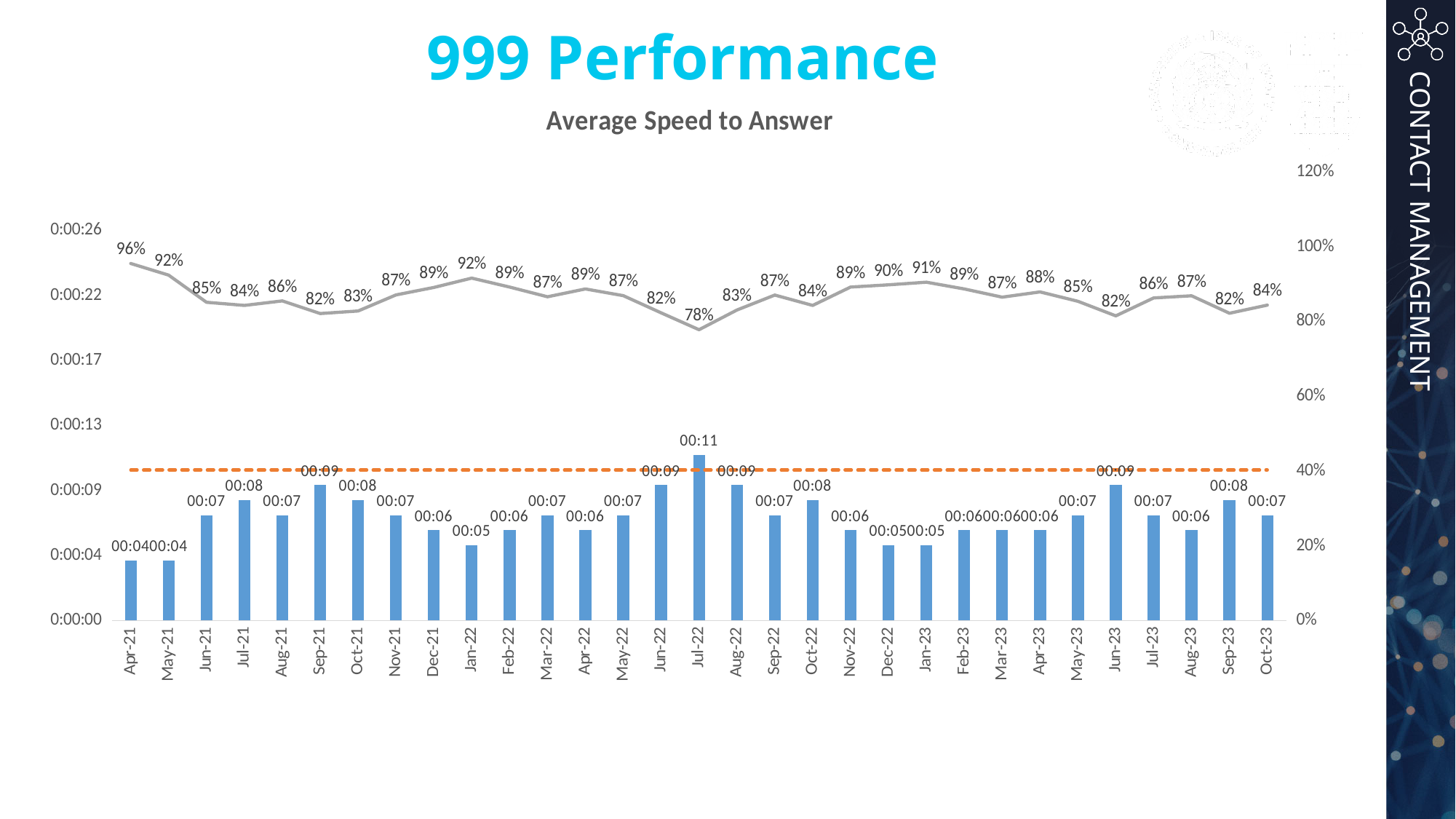
Which month has the highest percentage value on the line? Apr-21 Which month has the highest average speed to answer bar? Jul-22 How many months are plotted along the x axis? 31 What percentage value is shown on the line for Apr-21? 96% Which month has the lowest percentage value on the line? Jul-22 What is the difference in percentage points between the line values for Apr-21 and Oct-23? 12 percentage points What is the title of the chart? Average Speed to Answer Which month has a higher average speed to answer bar, Sep-21 or Jan-22? Sep-21 What is the average speed to answer shown for Oct-23? 00:07 What kind of chart is this? Combined bar and line chart What percentage value is shown on the line for Dec-22? 90% What is the average speed to answer shown for Jul-22? 00:11